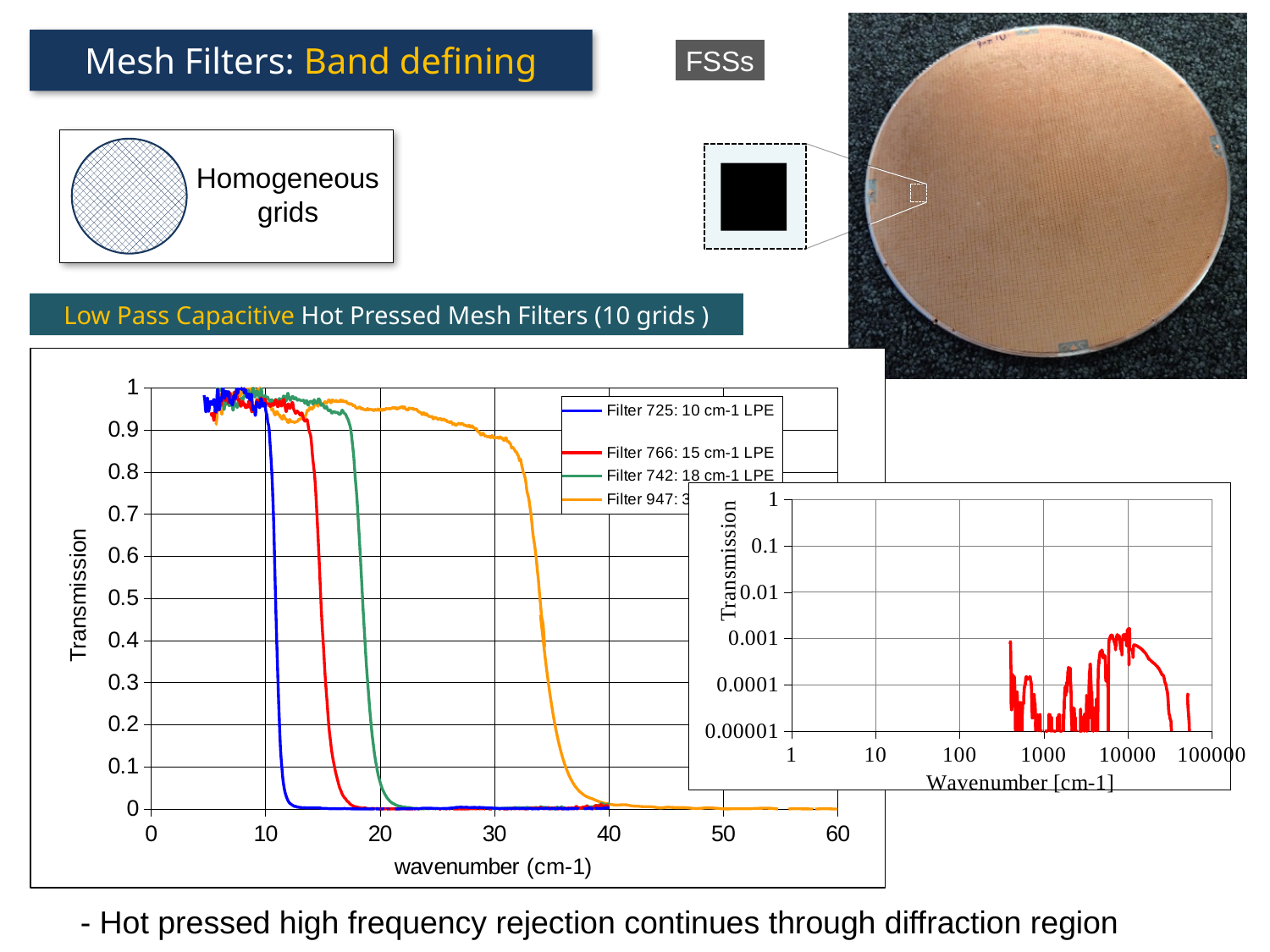
In the large Transmission chart, at wavenumber 20, which line has the higher transmission: the orange line or the blue line? the orange line In the large Transmission chart, which filter's transmission drops to near zero at the lowest wavenumber? Filter 725: 10 cm-1 LPE In the large Transmission chart, how does the transmission of each filter change as wavenumber increases beyond its cutoff? it falls In the inset chart with Wavenumber [cm-1] on a log axis, what is the lowest tick value shown on the Transmission axis? 0.00001 What kind of chart is the large chart of Transmission versus wavenumber (cm-1)? line chart In the large Transmission chart, is the transmission of Filter 725: 10 cm-1 LPE at wavenumber 20 greater or less than 0.1? less In the large Transmission chart, what colour is the line for Filter 766: 15 cm-1 LPE? red In the inset chart with Wavenumber [cm-1] on a log axis, is the transmission at wavenumber 1000 greater or less than 0.001? less In the large Transmission chart, is the transmission of Filter 742: 18 cm-1 LPE at wavenumber 30 greater or less than 0.1? less In the large Transmission chart, what is the legend entry for the blue line? Filter 725: 10 cm-1 LPE